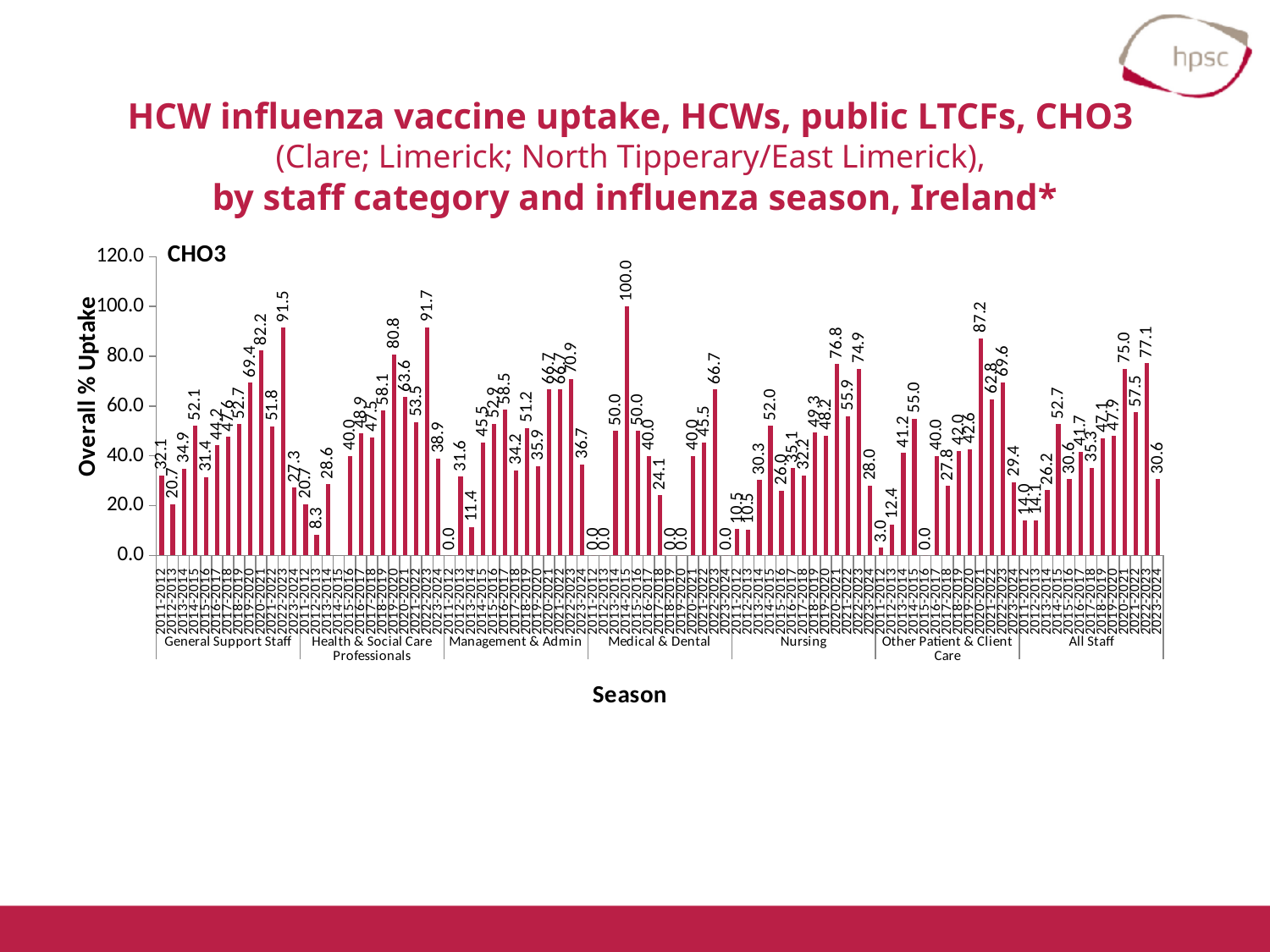
What type of chart is shown on the slide? Bar chart What is the overall % uptake for All Staff in 2020-2021? 75.0 In 2020-2021, which had the higher uptake: Nursing or Other Patient & Client Care? Other Patient & Client Care In which season did Health & Social Care Professionals have the highest uptake? 2022-2023 What is the difference between the All Staff uptake in 2022-2023 and in 2023-2024? 46.5 What is the title of the vertical axis? Overall % Uptake What is the overall % uptake for Other Patient & Client Care in 2020-2021? 87.2 Which staff category and season has the highest overall % uptake in the chart? Medical & Dental, 2014-2015 (100.0) What is the overall % uptake for All Staff in 2023-2024? 30.6 In which season did General Support Staff have the highest uptake? 2022-2023 What is the overall % uptake for All Staff in 2022-2023? 77.1 How many staff categories are shown along the x axis? 7